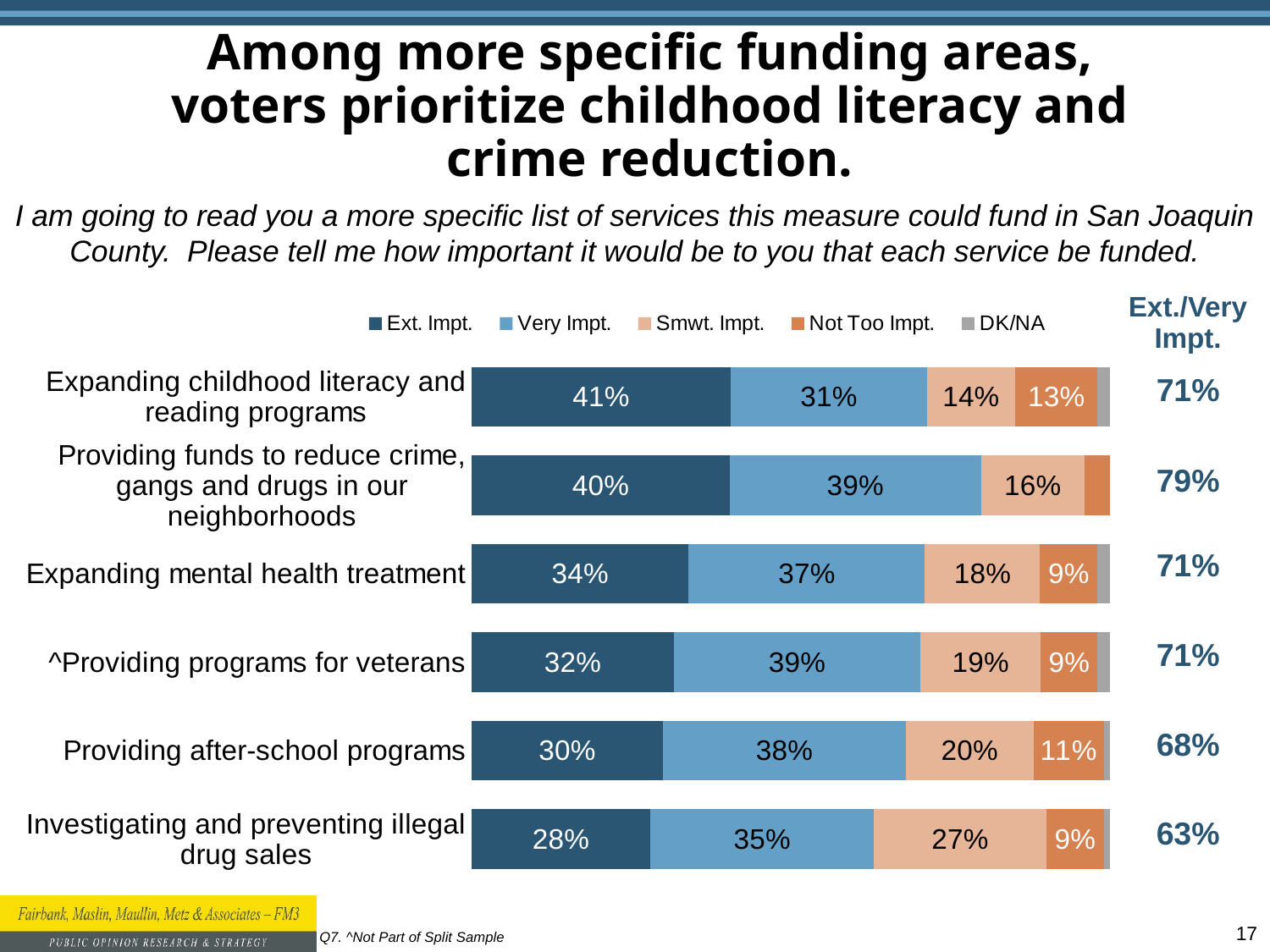
What is the difference in Smwt. Impt. percentage between investigating and preventing illegal drug sales and expanding childhood literacy and reading programs? 13 percentage points What is the Ext./Very Impt. combined figure shown for providing funds to reduce crime, gangs and drugs in our neighborhoods? 79% What is the Not Too Impt. value for providing after-school programs? 11% What type of chart is shown on the slide? Stacked bar chart Which service has the highest Ext. Impt. percentage? Expanding childhood literacy and reading programs Which service has the lowest Ext. Impt. percentage? Investigating and preventing illegal drug sales Which has a larger Very Impt. percentage: expanding mental health treatment or providing after-school programs? Providing after-school programs What is the Very Impt. value for providing funds to reduce crime, gangs and drugs in our neighborhoods? 39% Which service has the highest Ext./Very Impt. combined figure? Providing funds to reduce crime, gangs and drugs in our neighborhoods How many services are listed in the chart? 6 What percentage of voters rated expanding childhood literacy and reading programs as Ext. Impt.? 41% How many response categories does the legend list? 5